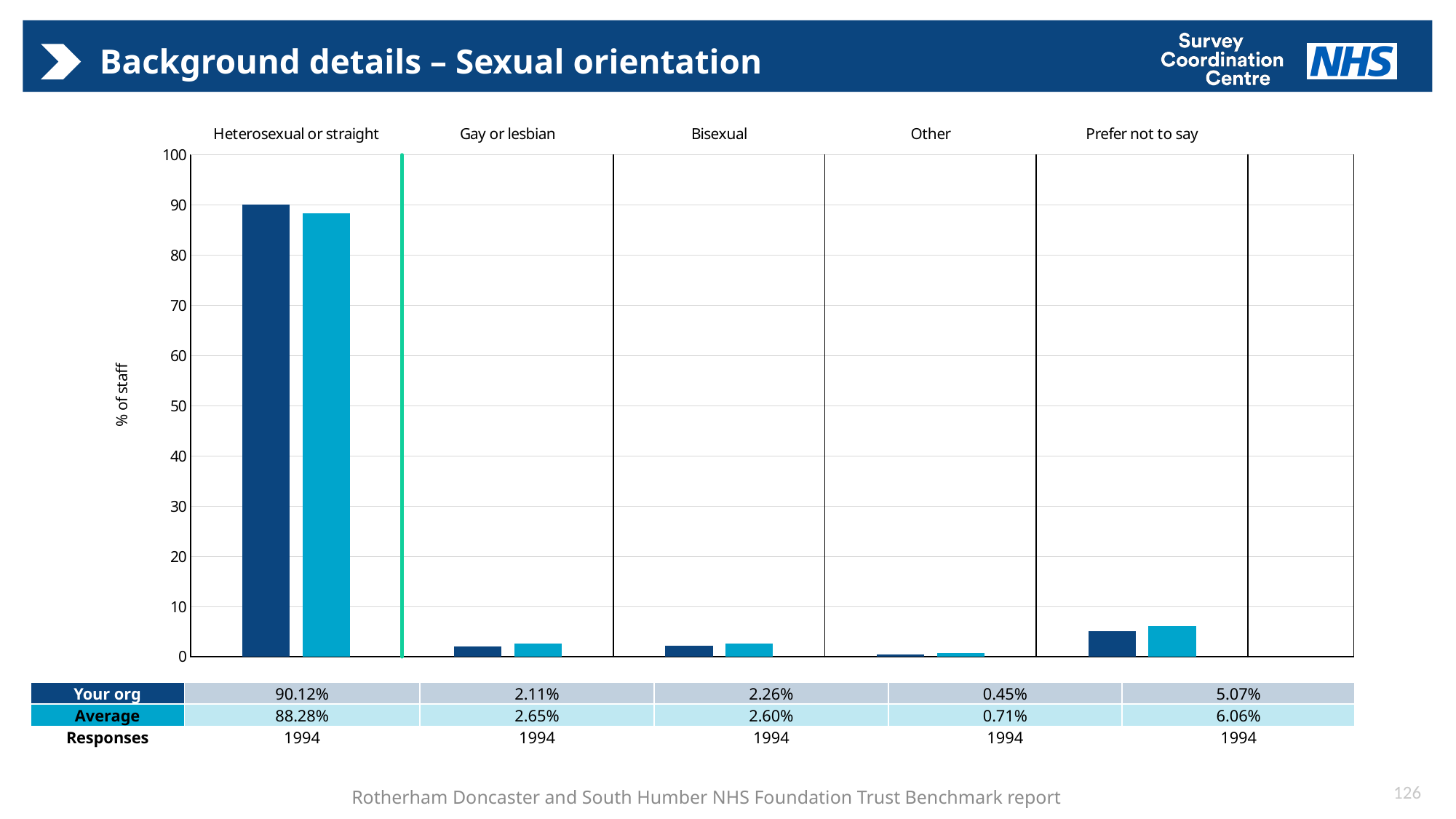
Is the 'Your org' value for Heterosexual or straight greater or less than 80? greater Which category has the lowest Average value? Other What is the 'Your org' value for Heterosexual or straight? 90.12% What is the 'Your org' value for Bisexual? 2.26% What is the difference between the 'Your org' and Average values for Heterosexual or straight? 1.84% How many series does the chart show? 2 Which category has the highest 'Your org' value? Heterosexual or straight What is the Average value for Prefer not to say? 6.06% What is the number of responses shown for the Other category? 1994 How many sexual orientation categories are shown on the chart? 5 What kind of chart is shown on the slide? Bar chart For Gay or lesbian, which is larger: the 'Your org' value or the Average value? Average